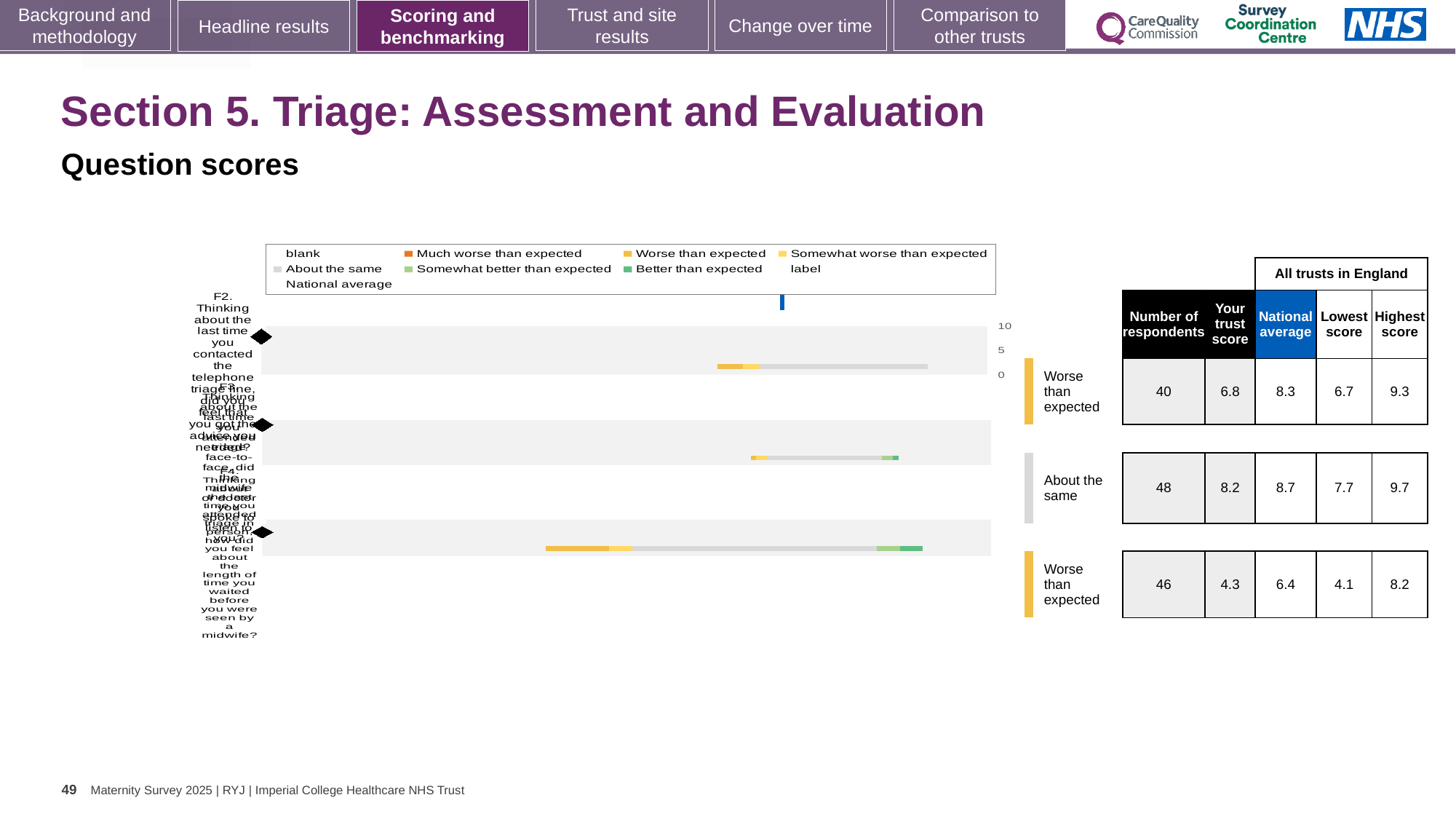
In the table beside the chart, is 'Your trust score' or the national average larger for the first row? national average In the table beside the chart, which row has the lowest 'Your trust score'? the third row (4.3) In the chart legend, what colour is used for 'Much worse than expected'? orange In the table beside the chart, what is the number of respondents for the first row? 40 What kind of chart is shown on the slide? bar chart In the table beside the chart, what is the highest score for the first row? 9.3 In the table beside the chart, what is the difference between the national average and 'Your trust score' for the third row? 2.1 In the table beside the chart, which row has the highest number of respondents? the second row (48) What benchmark label is shown next to the second row of the table? About the same In the table beside the chart, what is the national average for the second row? 8.7 In the chart legend, what colour is used for 'Better than expected'? green In the table beside the chart, what is 'Your trust score' for the third row? 4.3